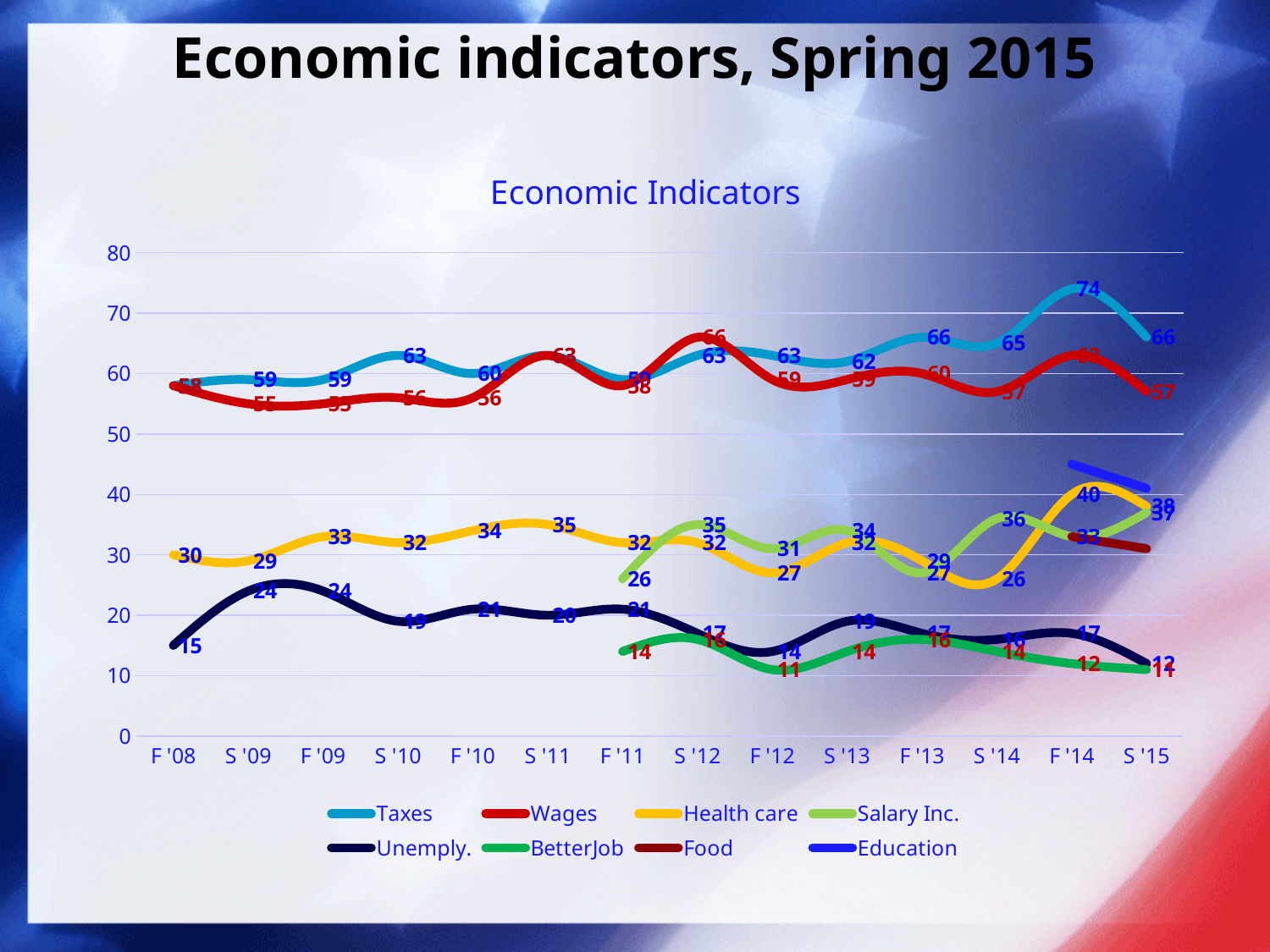
At F '14, which is higher, Taxes or Wages? Taxes What is the difference between the Taxes value at F '14 and at S '15? 8 In which period does Taxes reach its highest value? F '14 What is the value for Taxes at F '14? 74 What is the value for Wages at S '15? 57 Is the value for Education at F '14 greater or less than 40? greater What is the value for Unemply. at F '08? 15 How many series does the legend list? 8 How many time periods are shown on the x axis? 14 What is the value for Health care at F '08? 30 What is the value for Health care at F '14? 40 What type of chart is shown on the slide? line chart